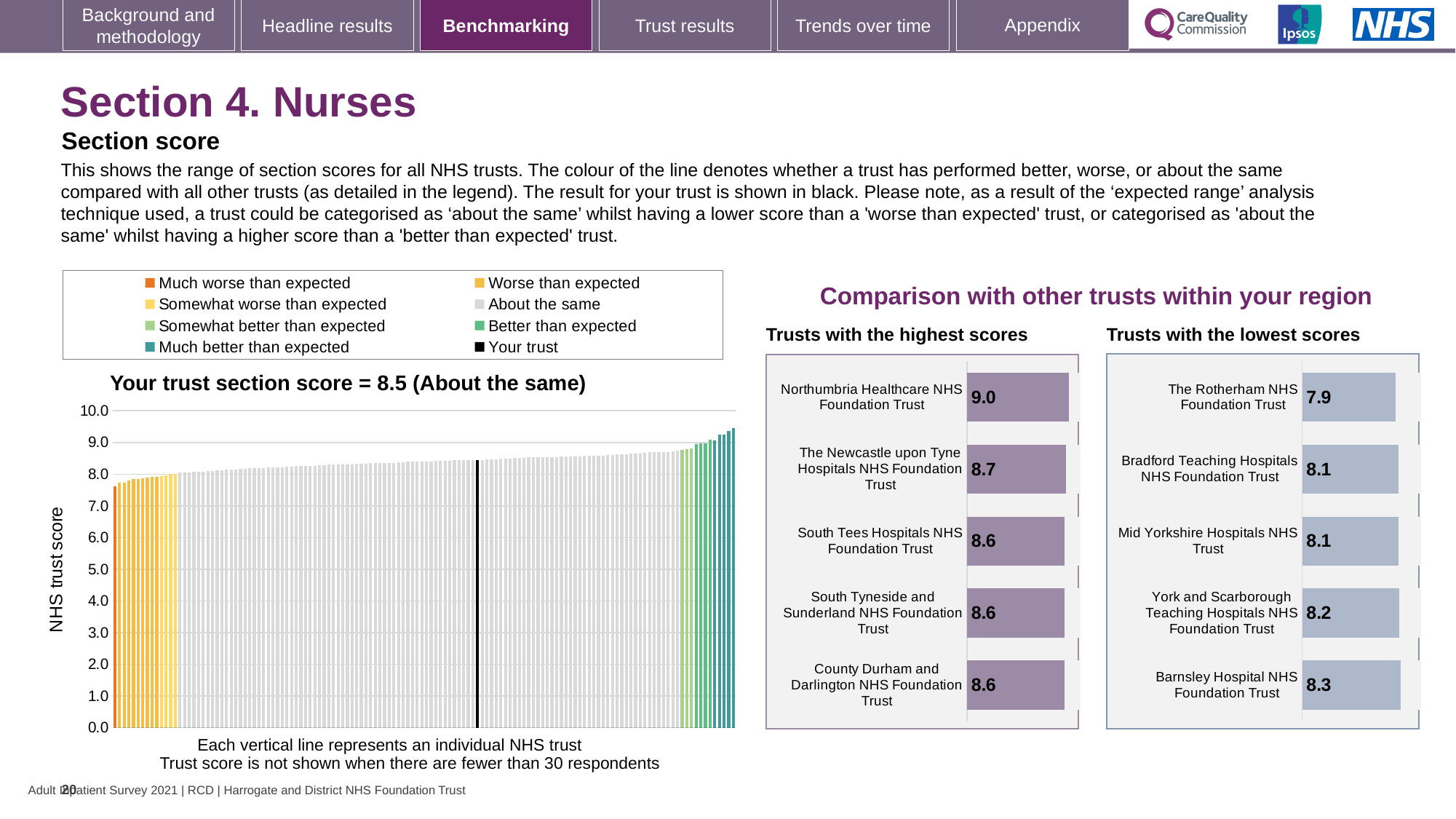
In the 'Trusts with the highest scores' chart, how many trusts are shown? 5 In the 'Trusts with the highest scores' chart, which trust has the highest score? Northumbria Healthcare NHS Foundation Trust In the main chart on the left showing the range of section scores for all NHS trusts, what is your trust's section score? 8.5 In the main chart on the left showing the range of section scores for all NHS trusts, how many entries does the legend list? 8 In the 'Trusts with the lowest scores' chart, which has the larger score: York and Scarborough Teaching Hospitals NHS Foundation Trust or Mid Yorkshire Hospitals NHS Trust? York and Scarborough Teaching Hospitals NHS Foundation Trust In the 'Trusts with the lowest scores' chart, which trust has the lowest score? The Rotherham NHS Foundation Trust In the 'Trusts with the lowest scores' chart, what is the difference between the scores of Barnsley Hospital NHS Foundation Trust and The Rotherham NHS Foundation Trust? 0.4 In the 'Trusts with the highest scores' chart, what is the score for The Newcastle upon Tyne Hospitals NHS Foundation Trust? 8.7 In the 'Trusts with the lowest scores' chart, which trust has the highest score? Barnsley Hospital NHS Foundation Trust In the 'Trusts with the highest scores' chart, what is the difference between the scores of Northumbria Healthcare NHS Foundation Trust and The Newcastle upon Tyne Hospitals NHS Foundation Trust? 0.3 In the 'Trusts with the lowest scores' chart, what is the score for The Rotherham NHS Foundation Trust? 7.9 In the 'Trusts with the highest scores' chart, what is the score for Northumbria Healthcare NHS Foundation Trust? 9.0